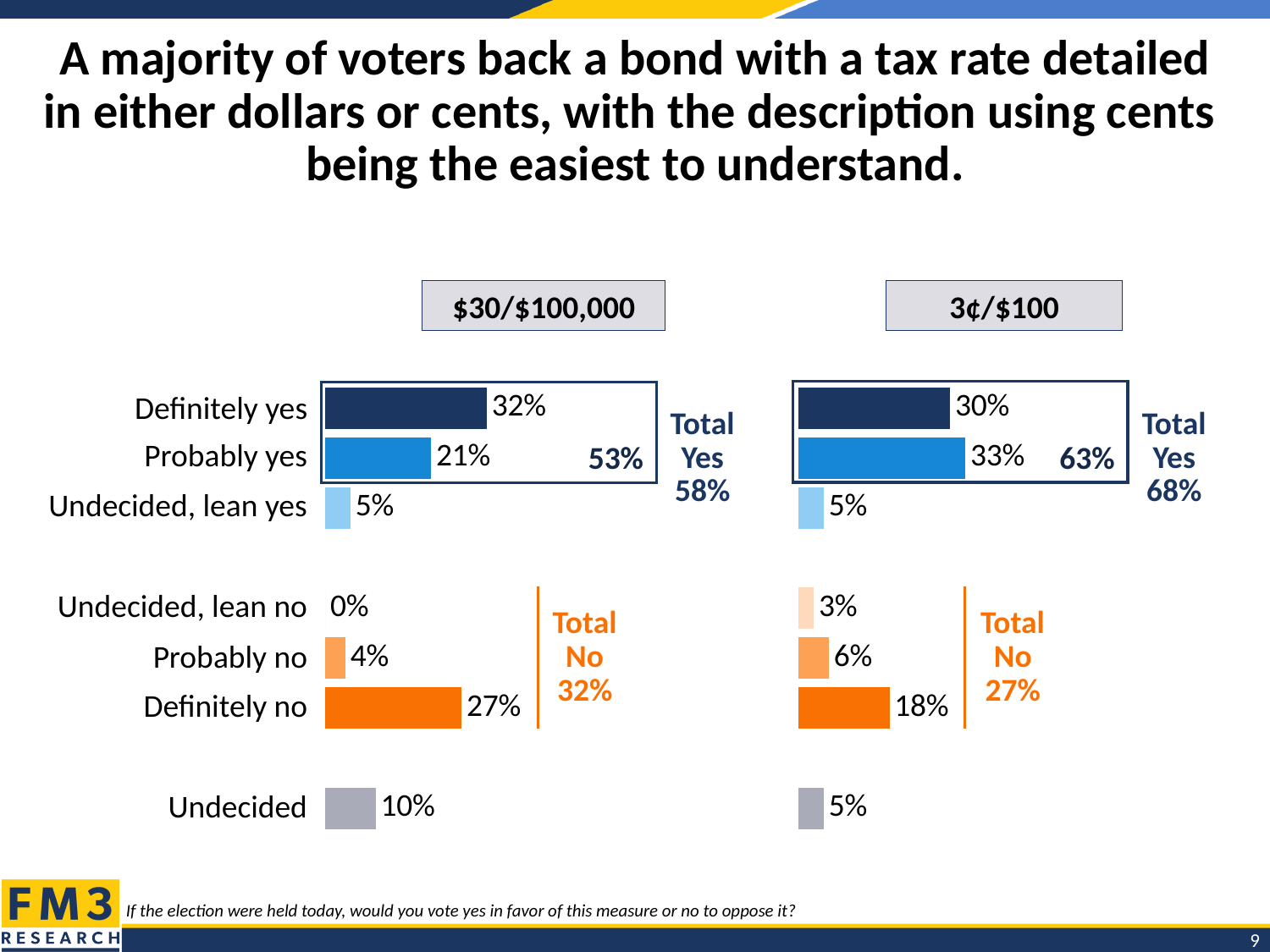
What is the Total Yes percentage shown for the 3¢/$100 chart? 68% In the $30/$100,000 chart, which response category has the lowest percentage? Undecided, lean no What is the Total No percentage shown for the $30/$100,000 chart? 32% In the 3¢/$100 chart, what percentage of voters said "Definitely no"? 18% In the 3¢/$100 chart, what percentage of voters said "Probably yes"? 33% In the $30/$100,000 chart, what percentage of voters were "Undecided"? 10% What kind of chart is used on this slide? Bar chart In the $30/$100,000 chart, which response category has the highest percentage? Definitely yes In the 3¢/$100 chart, which response category has the lowest percentage? Undecided, lean no What is the difference between the "Definitely no" percentages in the $30/$100,000 chart and the 3¢/$100 chart? 9% In the $30/$100,000 chart, what percentage of voters said "Definitely yes"? 32% Which chart has the larger "Probably yes" percentage, $30/$100,000 or 3¢/$100? 3¢/$100